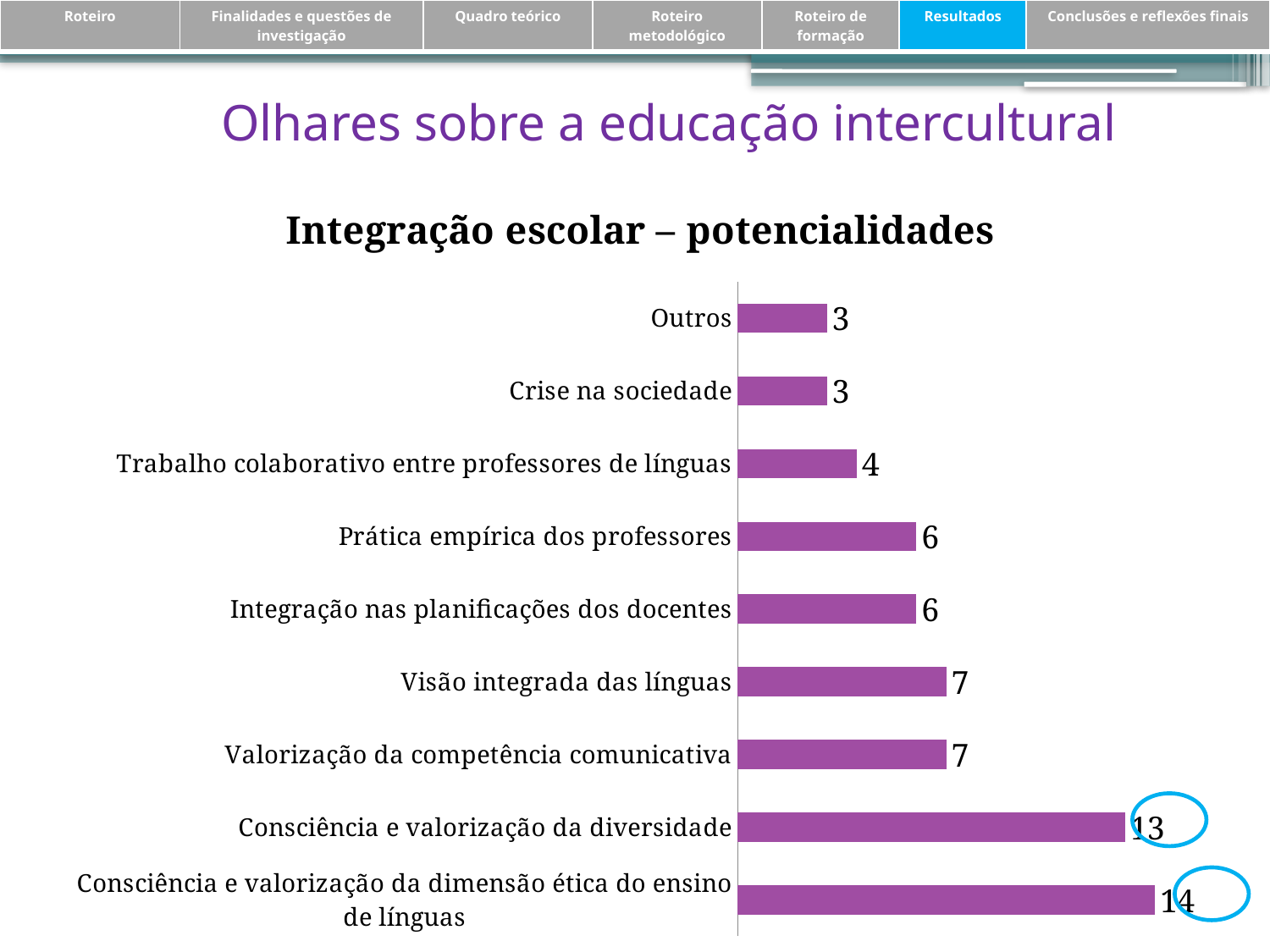
What kind of chart is shown on the slide? Bar chart What value is shown for "Crise na sociedade"? 3 What is the title of the chart? Integração escolar – potencialidades What colour are the bars in the chart? Purple What value is shown for "Trabalho colaborativo entre professores de línguas"? 4 How many categories are shown in the chart? 9 What value is shown for "Consciência e valorização da diversidade"? 13 What value is shown for "Visão integrada das línguas"? 7 Which is larger: the value for "Prática empírica dos professores" or the value for "Trabalho colaborativo entre professores de línguas"? Prática empírica dos professores Which category has the highest value? Consciência e valorização da dimensão ética do ensino de línguas What is the difference between the values for "Consciência e valorização da dimensão ética do ensino de línguas" and "Consciência e valorização da diversidade"? 1 What is the difference between the values for "Valorização da competência comunicativa" and "Outros"? 4